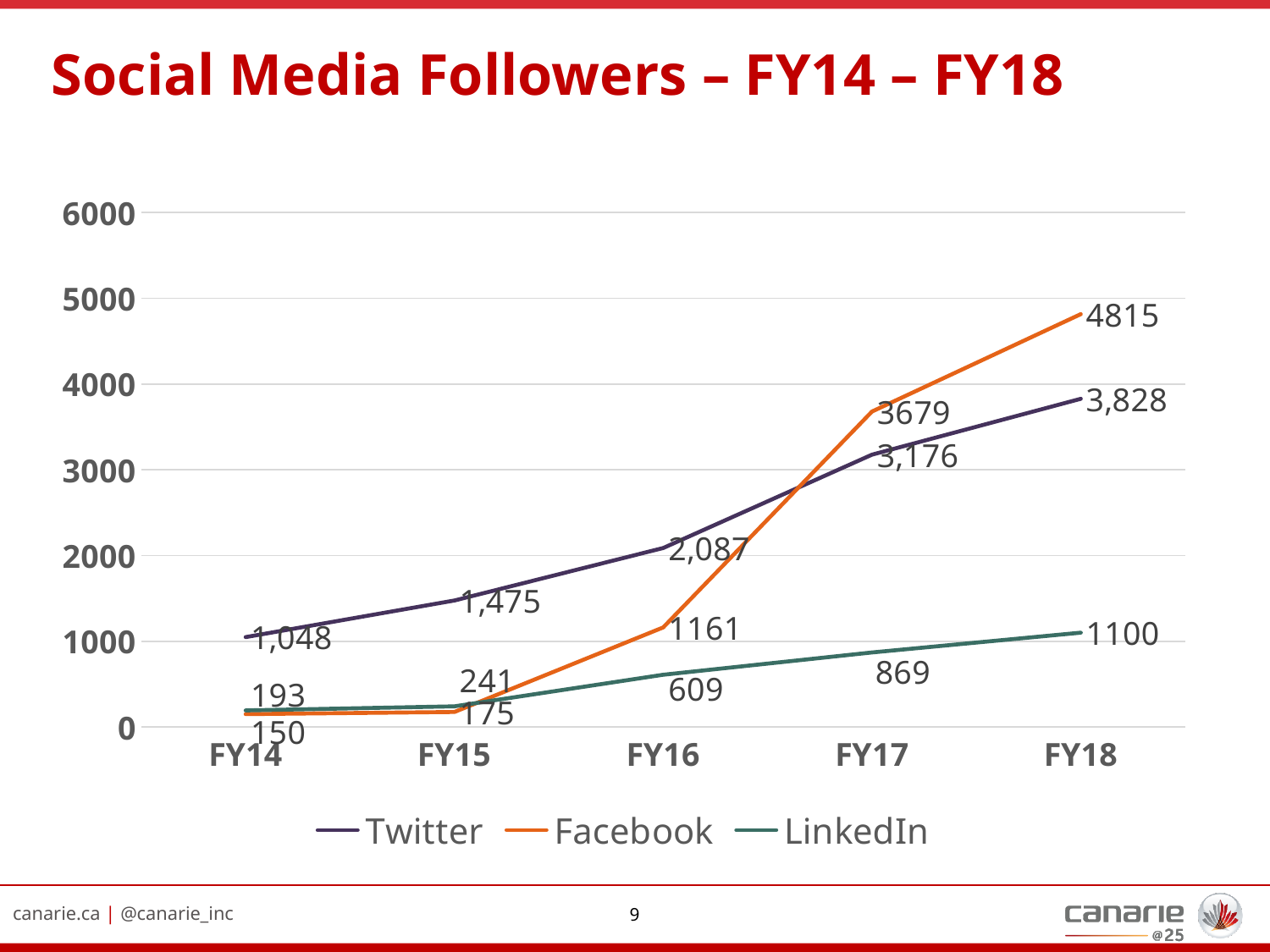
How many Twitter followers are shown for FY18? 3,828 What is the difference between the Facebook and Twitter values in FY18? 987 Which series has the highest value in FY18? Facebook How many series does the legend list? 3 What is the LinkedIn follower value for FY16? 609 In which fiscal year is the Facebook value lowest? FY14 What kind of chart is shown on the slide? line chart Do the LinkedIn values rise or fall from FY14 to FY18? rise In FY16, which is larger: the Twitter value or the Facebook value? Twitter How many fiscal years are plotted on the x axis? 5 What is the Facebook follower value for FY17? 3679 Is the Twitter value for FY17 greater or less than 3000? greater